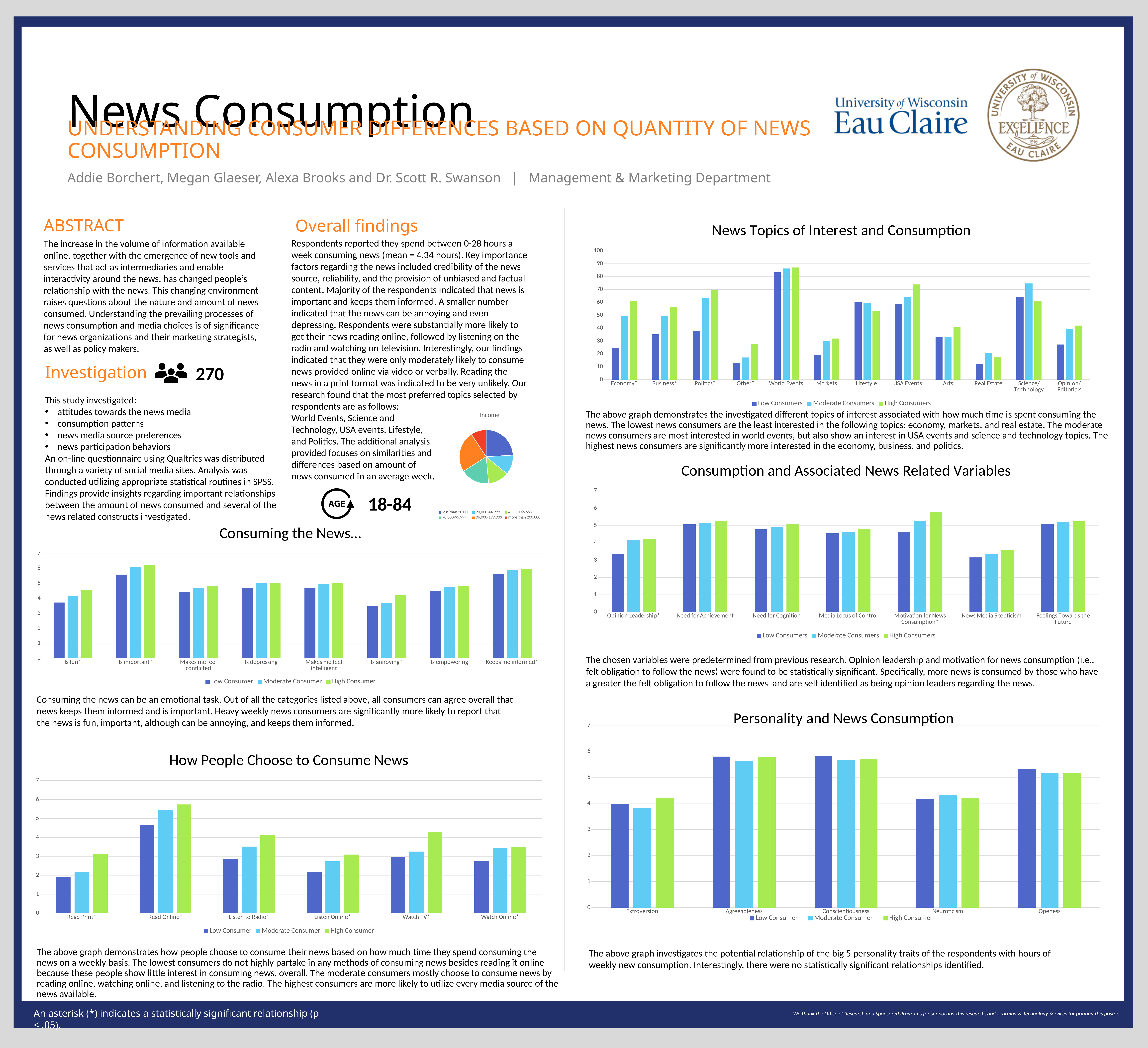
In the 'News Topics of Interest and Consumption' chart, is the Low Consumers value for 'Economy*' greater or less than 30? less In the 'How People Choose to Consume News' chart, is the Low Consumer value for 'Read Print*' greater or less than 3? less In the 'Consuming the News...' chart, is the Low Consumer value for 'Is annoying*' greater or less than 4? less In the 'Consumption and Associated News Related Variables' chart, which variable has the highest High Consumers value? Motivation for News Consumption* In the 'News Topics of Interest and Consumption' chart, how many topics are shown on the x axis? 12 In the 'How People Choose to Consume News' chart, how many categories are shown on the x axis? 6 In the 'News Topics of Interest and Consumption' chart, which topic has the highest Moderate Consumers value? World Events How many slices does the 'Income' pie chart have? 6 In the 'Consuming the News...' chart, how many series does the legend list? 3 In the 'News Topics of Interest and Consumption' chart, which is larger for High Consumers: Politics* or Business*? Politics* In the 'How People Choose to Consume News' chart, which category has the highest High Consumer value? Read Online*